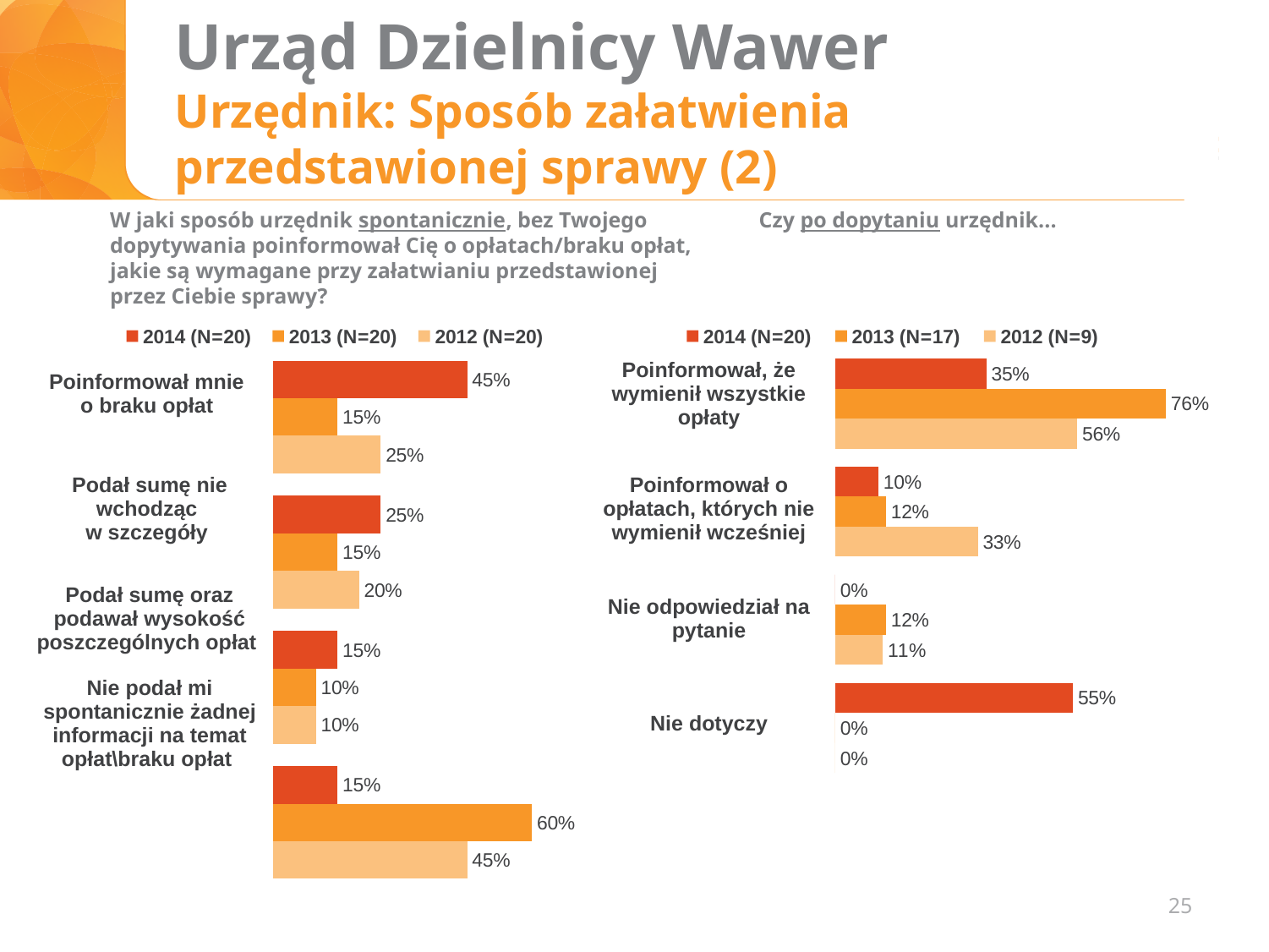
How many categories does the right chart show? 4 In the right chart, what is the 2014 value for "Nie dotyczy"? 55% In the left chart, what is the 2013 value for "Nie podał mi spontanicznie żadnej informacji na temat opłat\braku opłat"? 60% In the left chart, which category has the highest 2014 value? Poinformował mnie o braku opłat How many series does the legend of the left chart list? 3 In the left chart, what is the difference between the 2013 and 2014 values for "Nie podał mi spontanicznie żadnej informacji na temat opłat\braku opłat"? 45% In the left chart (spontaneous information about fees), what is the 2014 value for "Poinformował mnie o braku opłat"? 45% In the right chart, which is larger for "Poinformował o opłatach, których nie wymienił wcześniej": the 2012 value or the 2014 value? 2012 In the right chart ("Czy po dopytaniu urzędnik..."), what is the 2013 value for "Poinformował, że wymienił wszystkie opłaty"? 76% In the right chart, which category has the lowest 2012 value? Nie dotyczy What type of chart is used on the left side of the slide? Bar chart In the right chart's legend, what is the sample size (N) given for 2012? N=9